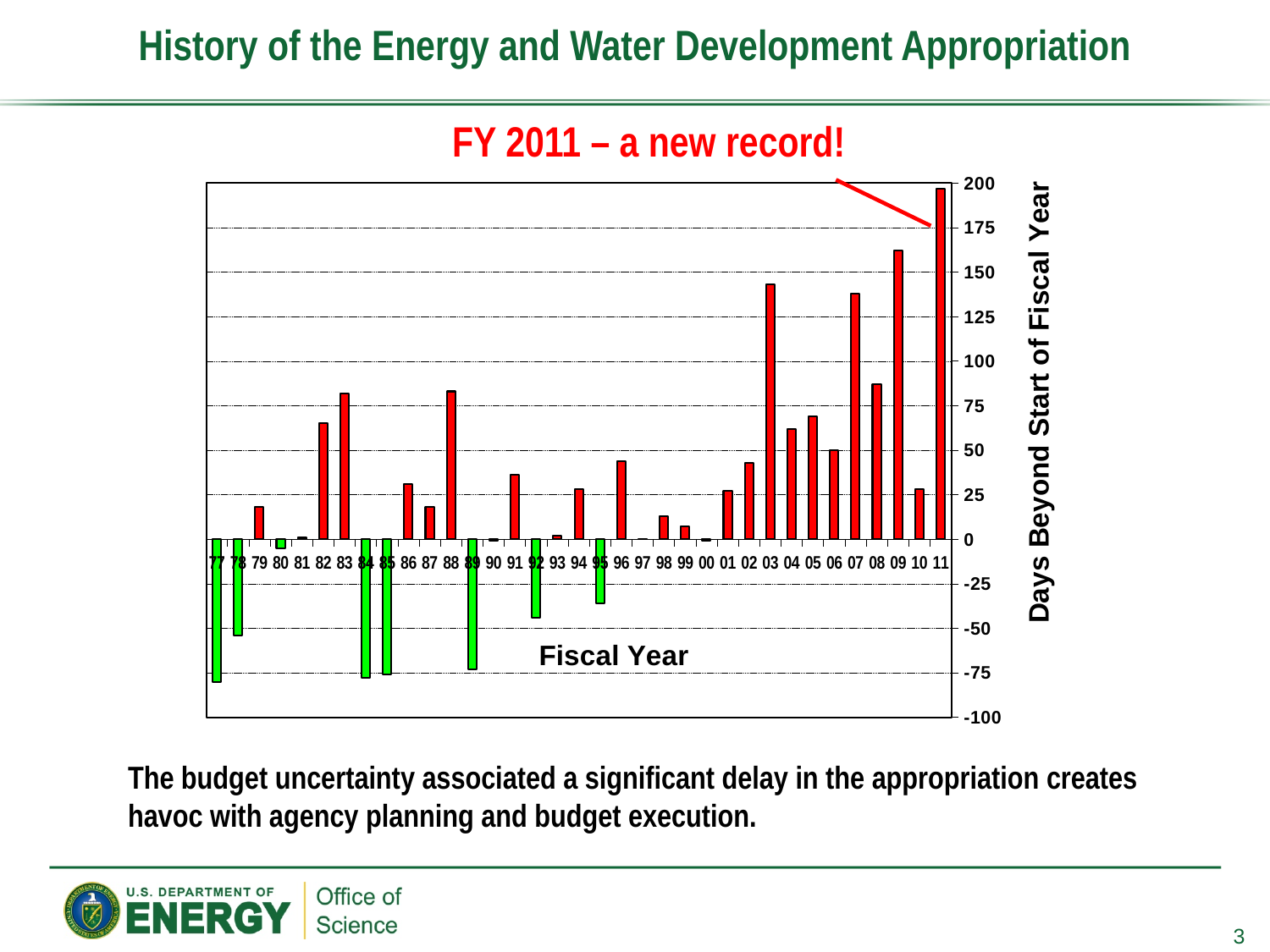
Is the value for fiscal year 88 greater or less than 75? greater How many fiscal years are plotted on the x axis of the chart? 35 Do the values rise or fall from fiscal year 01 to fiscal year 03? rise Is the value for fiscal year 03 greater or less than 125? greater Which has the larger value, fiscal year 82 or fiscal year 83? 83 Is the value for fiscal year 11 greater or less than 175? greater What kind of chart is shown on the slide? bar chart Which has the larger value, fiscal year 09 or fiscal year 03? 09 Which fiscal year has the highest value in the chart? 11 What is the title of the vertical axis of the chart? Days Beyond Start of Fiscal Year